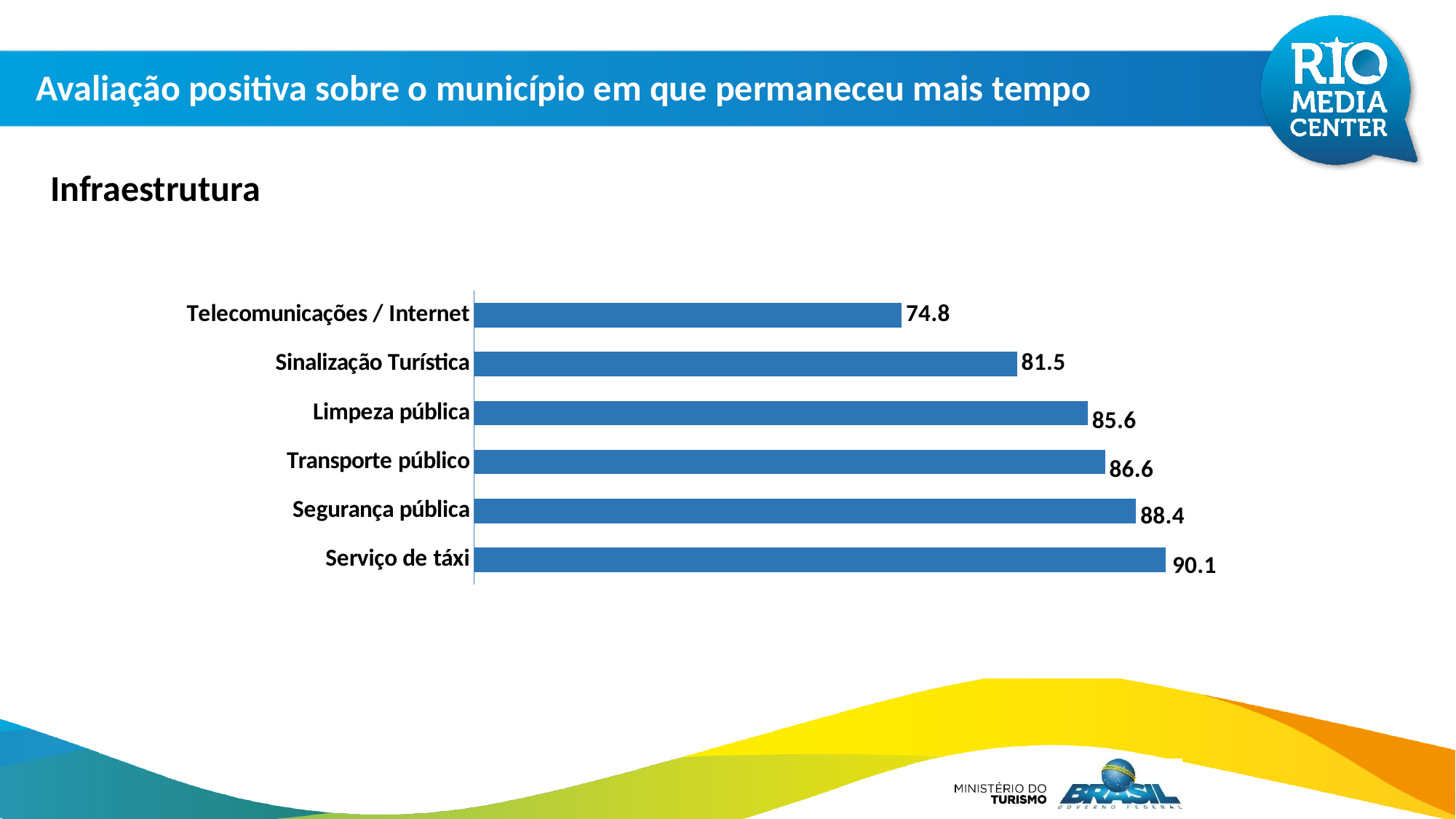
What is the value for Telecomunicações / Internet? 74.8 What is the difference between the values for Segurança pública and Transporte público? 1.8 What is the heading shown above the chart? Infraestrutura Which category has the highest value? Serviço de táxi Which category has the lowest value? Telecomunicações / Internet What kind of chart is shown on the slide? Bar chart What is the difference between the values for Serviço de táxi and Telecomunicações / Internet? 15.3 What is the value for Serviço de táxi? 90.1 What is the value for Sinalização Turística? 81.5 How many categories are shown in the chart? 6 Which is larger, the value for Limpeza pública or the value for Sinalização Turística? Limpeza pública What is the value for Limpeza pública? 85.6